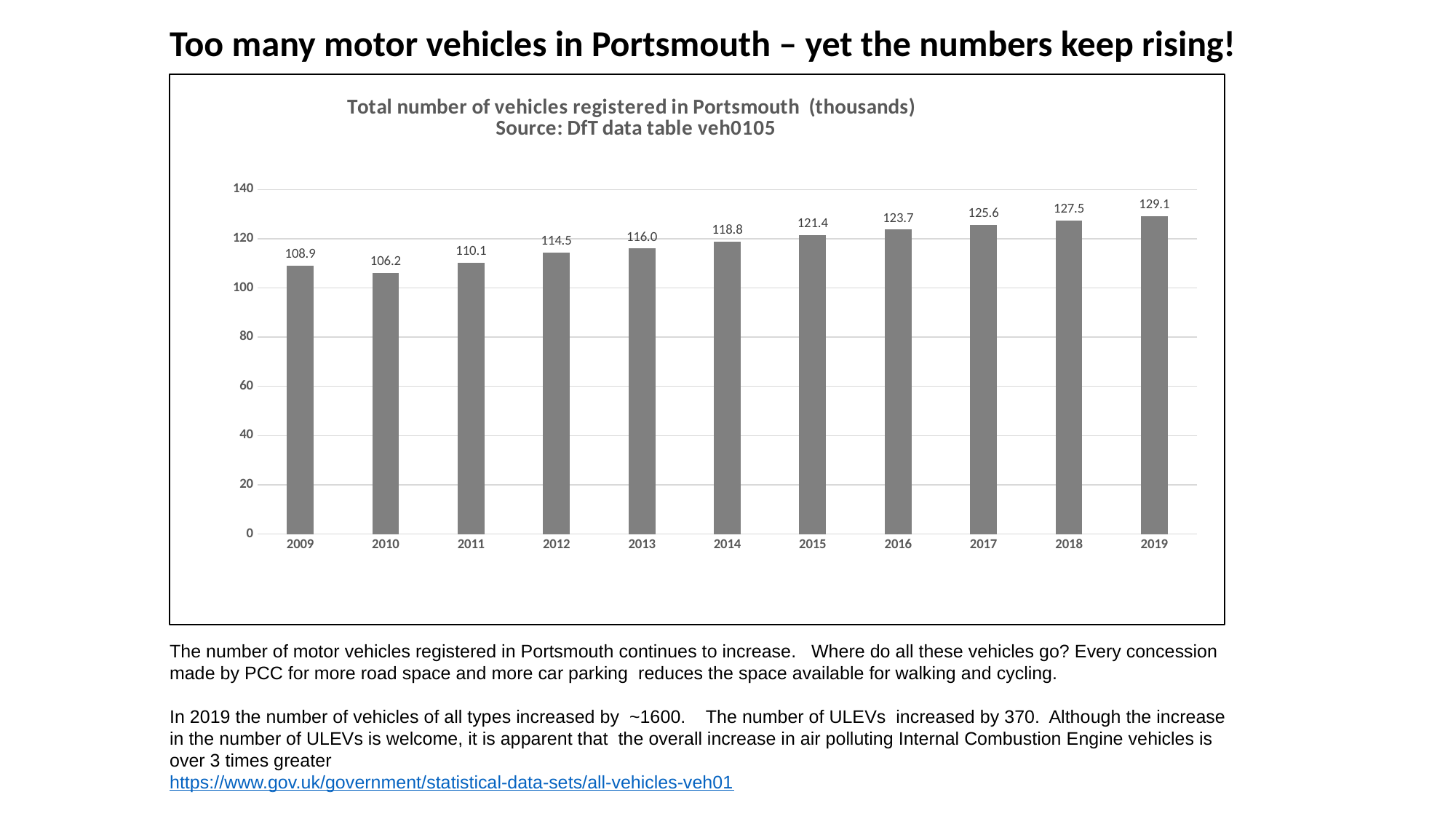
Do the values generally rise or fall from 2010 to 2019? rise What is the value for 2009? 108.9 What is the value for 2019? 129.1 Which year has the highest value? 2019 What kind of chart is shown? bar chart What is the difference between the values for 2019 and 2009? 20.2 What is the difference between the values for 2018 and 2017? 1.9 Which is larger, the value for 2012 or the value for 2010? 2012 Is the value for 2016 greater or less than 120? greater How many years are shown on the x axis? 11 Which year has the lowest value? 2010 What is the value for 2015? 121.4